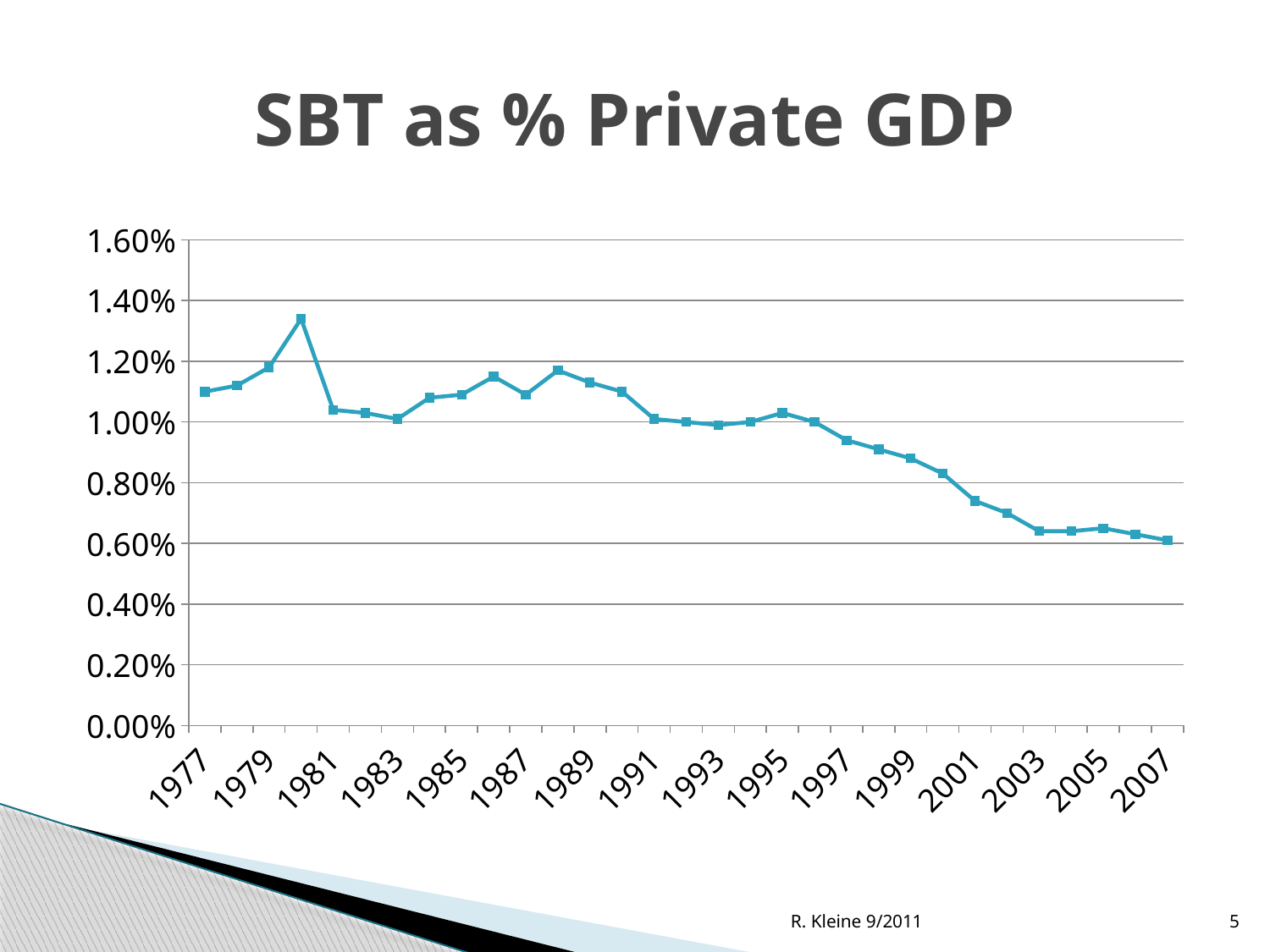
Is the value for 1980 greater or less than 1.20%? greater What is the title of the chart? SBT as % Private GDP What kind of chart is shown on the slide? line chart Is the value for 2007 greater or less than 0.80%? less What is the highest value shown on the y axis? 1.60% Which year has the larger value, 1977 or 2007? 1977 Overall, do the values rise or fall from 1977 to 2007? fall In which year does the line reach its highest value? 1980 Is the value for 1977 greater or less than 1.00%? greater Which year has the larger value, 1980 or 1989? 1980